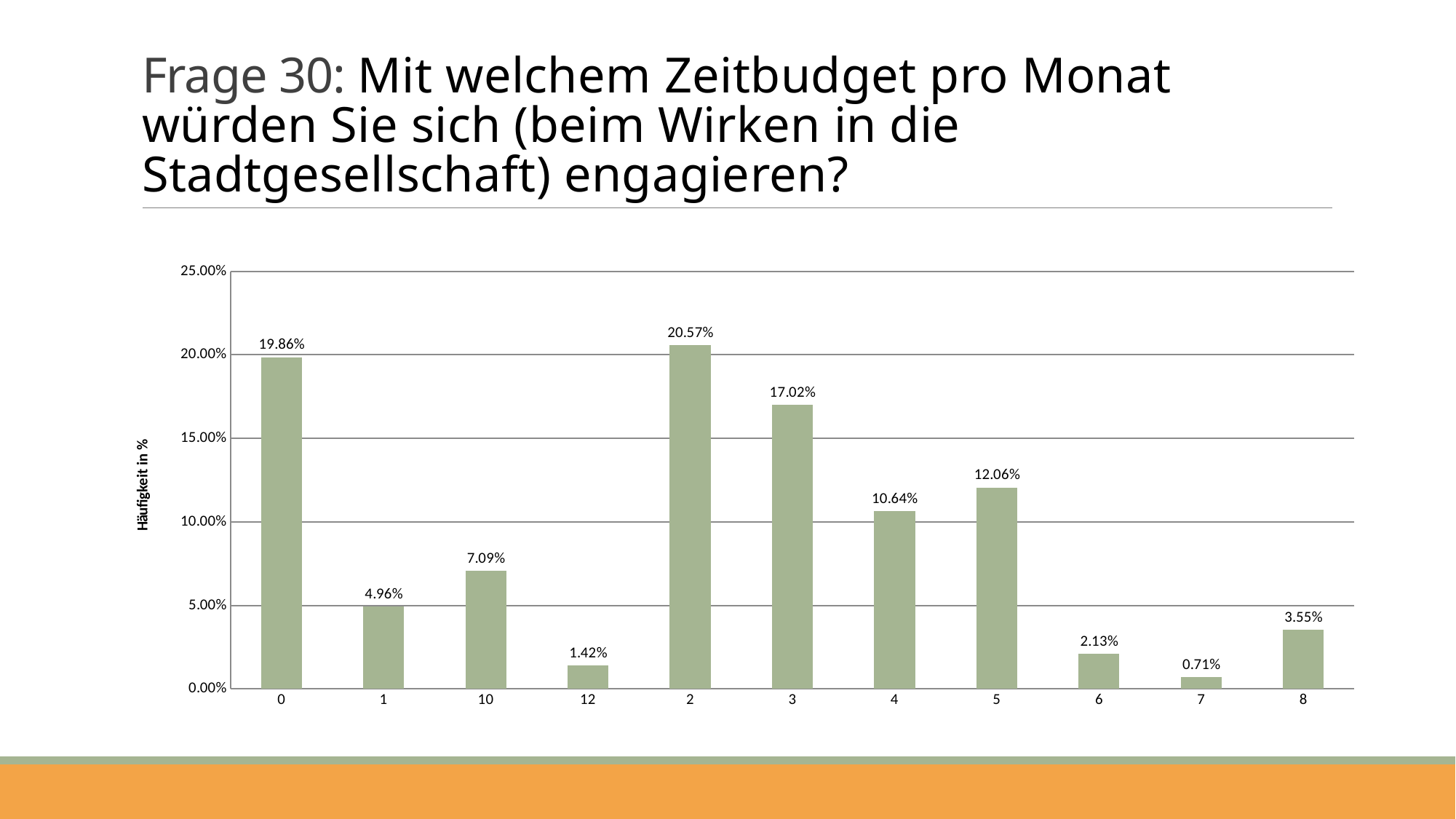
How many categories are shown on the x axis? 11 What is the difference between the values for category 3 and category 5? 4.96% What is the label of the vertical axis? Häufigkeit in % Which category has the highest value? 2 Which category has the lowest value? 7 Is the value for category 3 greater or less than 15.00%? greater What is the value for category 2? 20.57% What is the value for category 10? 7.09% What kind of chart is shown on the slide? bar chart What is the difference between the values for category 2 and category 0? 0.71% What is the value for category 7? 0.71% Which is larger, the value for category 4 or the value for category 5? 5